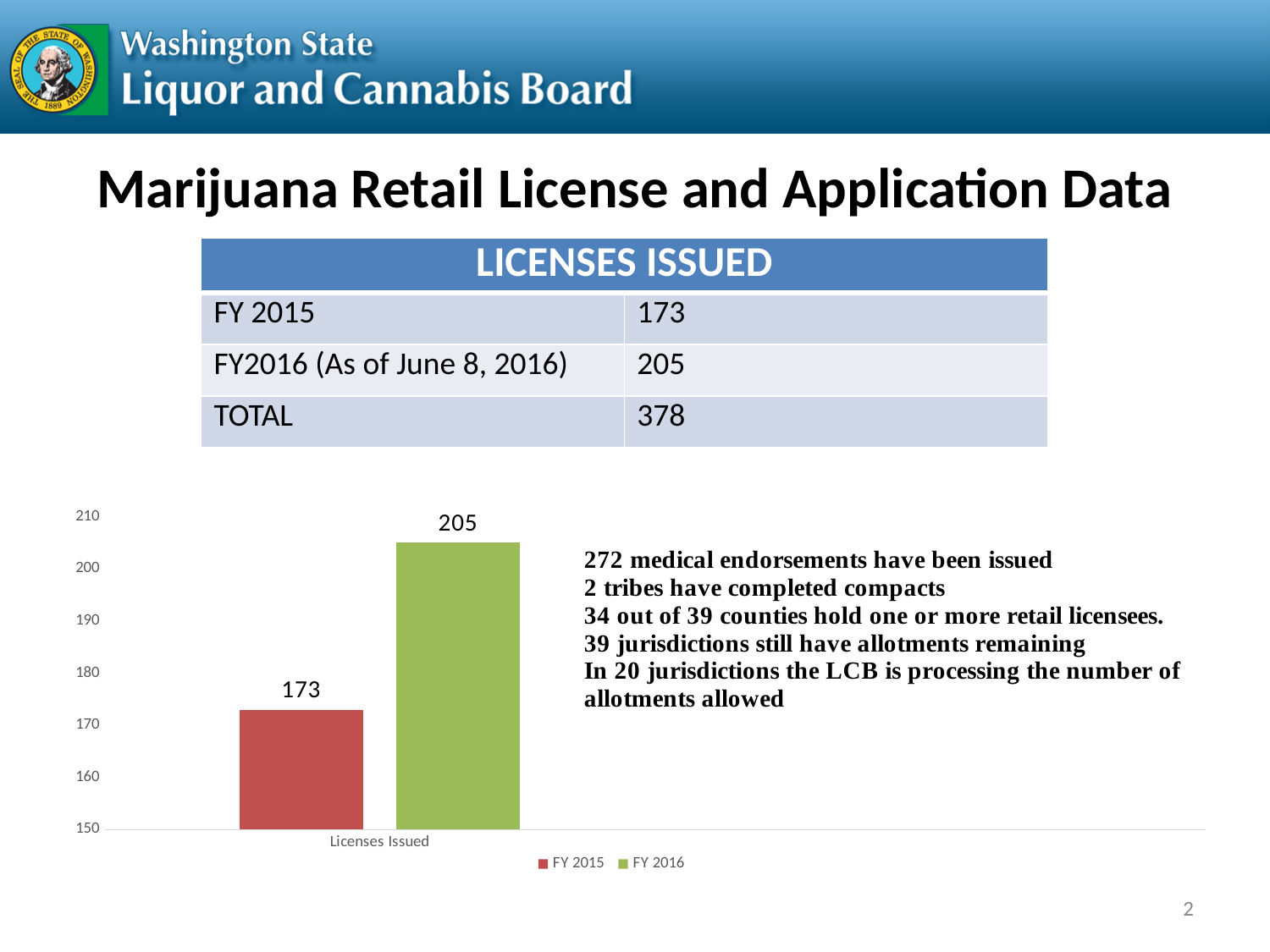
Is the value for FY 2016 greater or less than 200? greater What is the category label on the x axis of the chart? Licenses Issued What colour is the FY 2016 bar in the chart? green What is the value for FY 2016 in the Licenses Issued chart? 205 What kind of chart is shown on the slide? bar chart What is the value for FY 2015 in the Licenses Issued chart? 173 How many series does the chart legend list? 2 Is the FY 2015 value larger or smaller than the FY 2016 value? smaller Which series has the higher value in the chart, FY 2015 or FY 2016? FY 2016 Which series has the lower value in the chart? FY 2015 Is the value for FY 2015 greater or less than 180? less What is the difference between the FY 2016 and FY 2015 values in the chart? 32